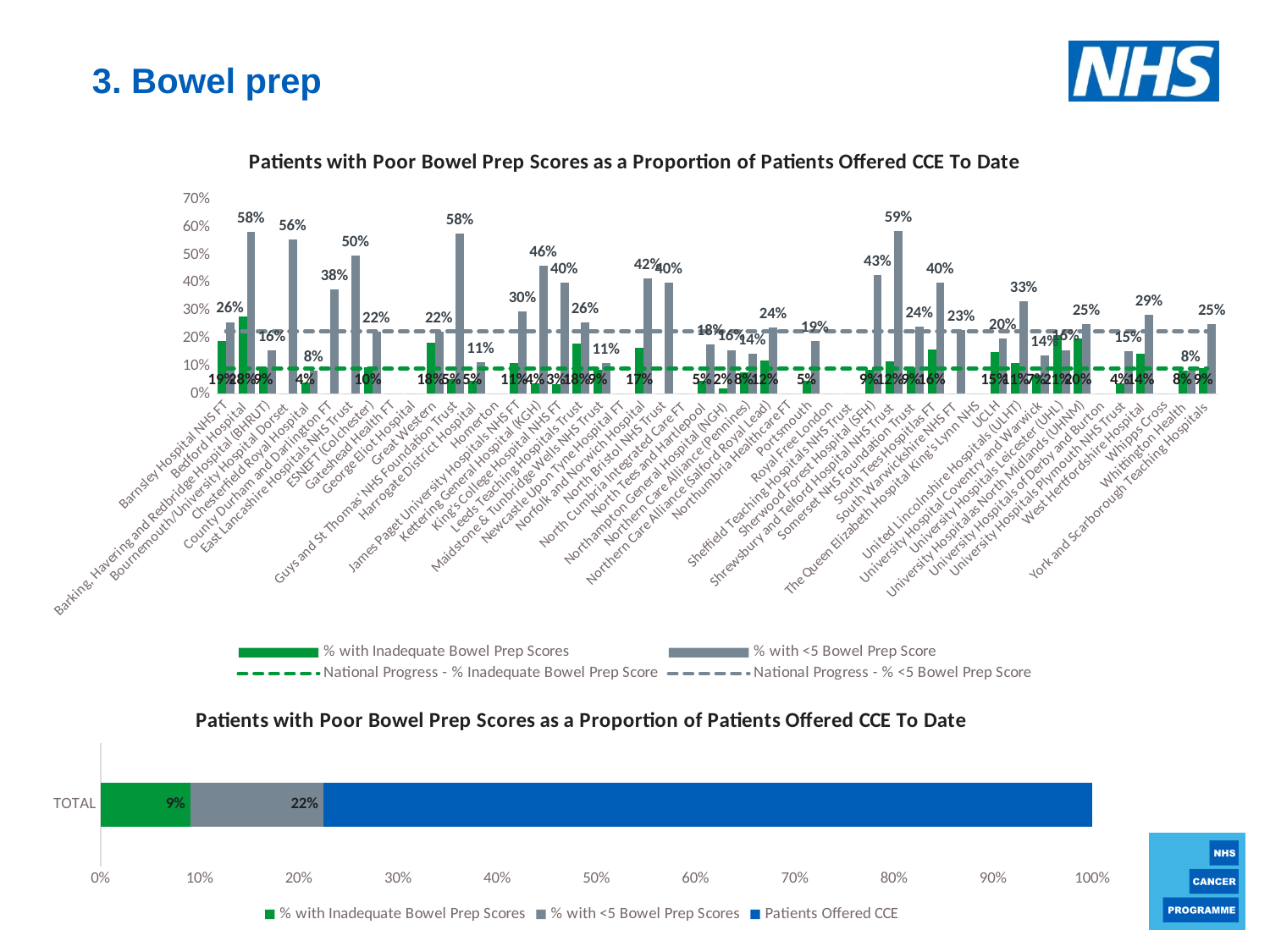
In the bottom chart, what is the value for '% with Inadequate Bowel Prep Scores' for TOTAL? 9% What kind of chart is the bottom chart titled 'Patients with Poor Bowel Prep Scores as a Proportion of Patients Offered CCE To Date'? Bar chart In the bottom chart, which is larger for TOTAL: '% with Inadequate Bowel Prep Scores' or '% with <5 Bowel Prep Scores'? % with <5 Bowel Prep Scores What kind of chart is the top chart on the slide? Combination bar and line chart In the bottom chart, how many series does the legend list? 3 In the top chart, what is the highest value shown for '% with <5 Bowel Prep Score'? 59% In the bottom chart, how many categories are shown on the vertical axis? 1 In the top chart, what is the maximum value shown on the vertical axis? 70% In the bottom chart, what colour is the 'Patients Offered CCE' series? Blue In the top chart, how many entries does the legend list? 4 In the bottom chart, what is the value for '% with <5 Bowel Prep Scores' for TOTAL? 22% In the bottom chart, what is the difference between the '% with <5 Bowel Prep Scores' value and the '% with Inadequate Bowel Prep Scores' value for TOTAL? 13 percentage points